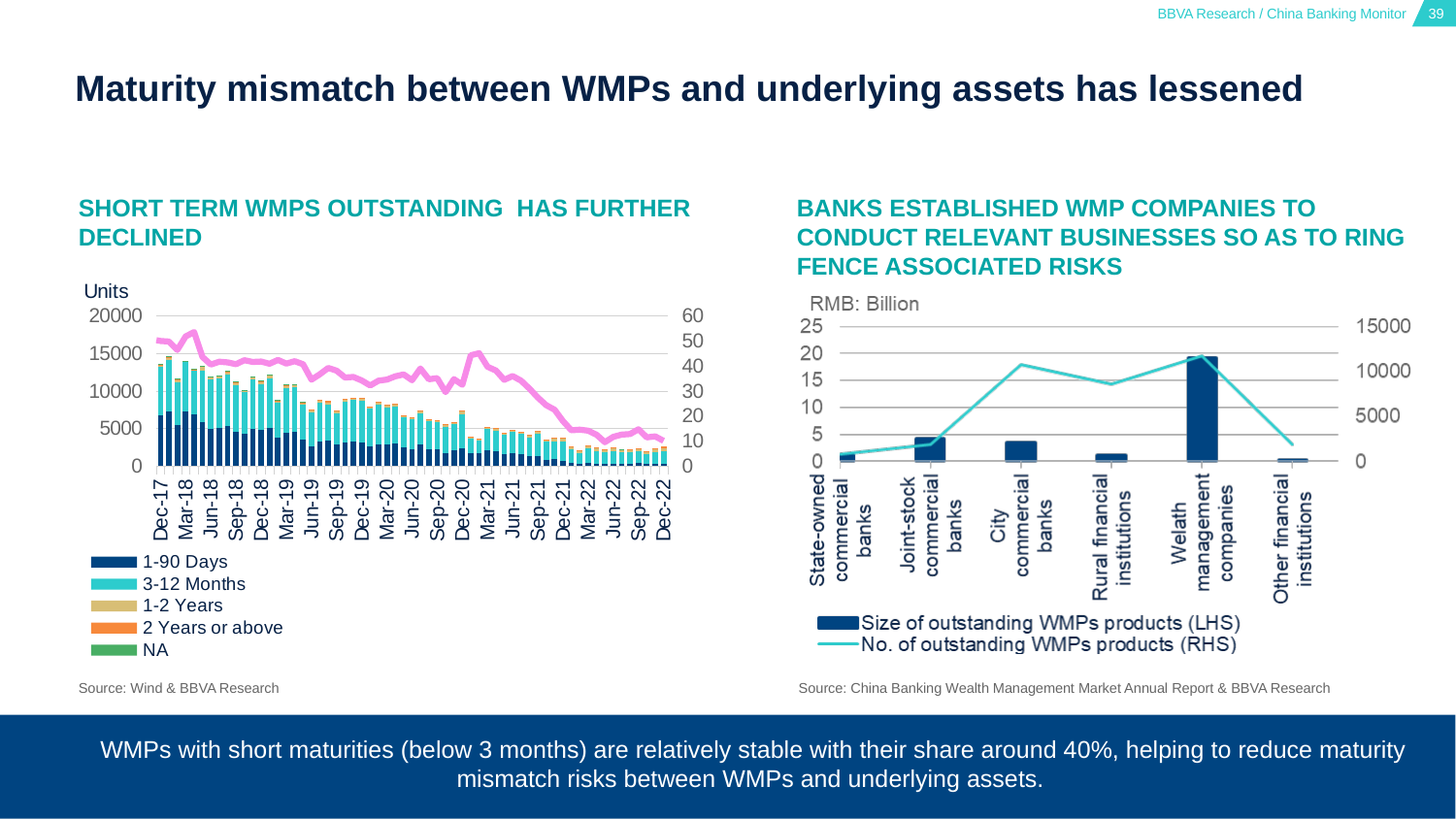
On the right chart, which category has the lowest bar for size of outstanding WMPs products? Other financial institutions On the left chart, do the stacked bars generally rise or fall from Dec-17 to Dec-22? fall On the left chart, is the pink line value at Dec-17 greater or less than 40 on the right-hand axis? greater On the right chart, is the bar for Wealth management companies greater or less than 15? greater On the right chart, is the bar for City commercial banks greater or less than 5? less On the right chart, how many categories are shown on the x axis? 6 On the left chart, how many entries does the legend list? 5 On the right chart, which category has the highest bar for size of outstanding WMPs products? Wealth management companies On the right chart, which is larger: the bar for Joint-stock commercial banks or the bar for Rural financial institutions? Joint-stock commercial banks On the left chart, what is the first legend entry? 1-90 Days